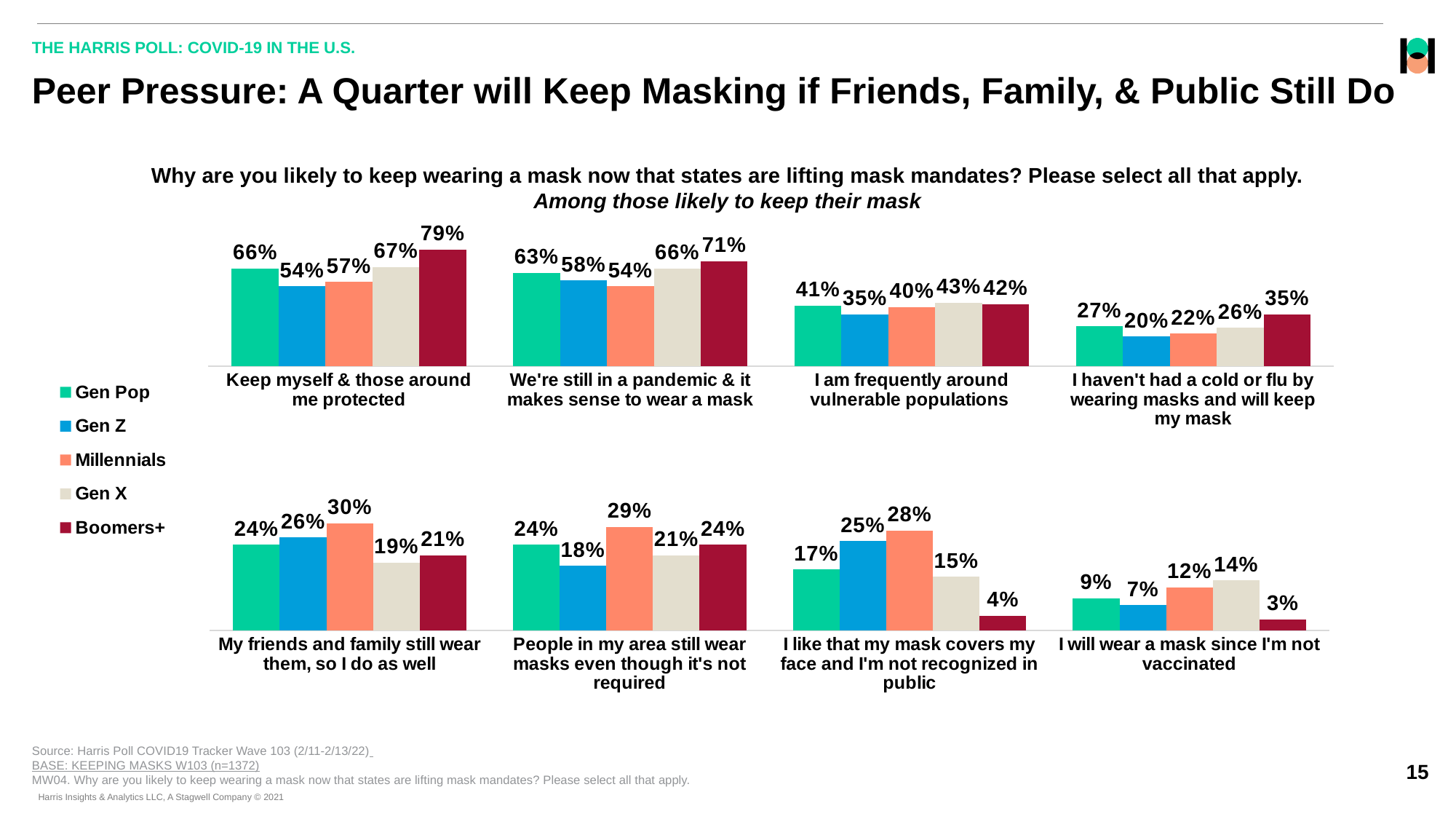
What is the Millennials value for "My friends and family still wear them, so I do as well"? 30% Which generation has the lowest value for "I like that my mask covers my face and I'm not recognized in public"? Boomers+ How many reason categories are plotted on the slide? 8 For "People in my area still wear masks even though it's not required", which is larger: the Millennials value or the Gen Z value? Millennials How many series does the legend list? 5 What percentage of Boomers+ selected "Keep myself & those around me protected"? 79% What is the Boomers+ value for "I will wear a mask since I'm not vaccinated"? 3% What kind of chart is shown on the slide? Bar chart What is the difference between the Boomers+ and Gen Z values for "Keep myself & those around me protected"? 25% Which generation has the highest value for "I haven't had a cold or flu by wearing masks and will keep my mask"? Boomers+ Which colour represents Gen X in the legend? Beige What is the Gen Z value for "We're still in a pandemic & it makes sense to wear a mask"? 58%